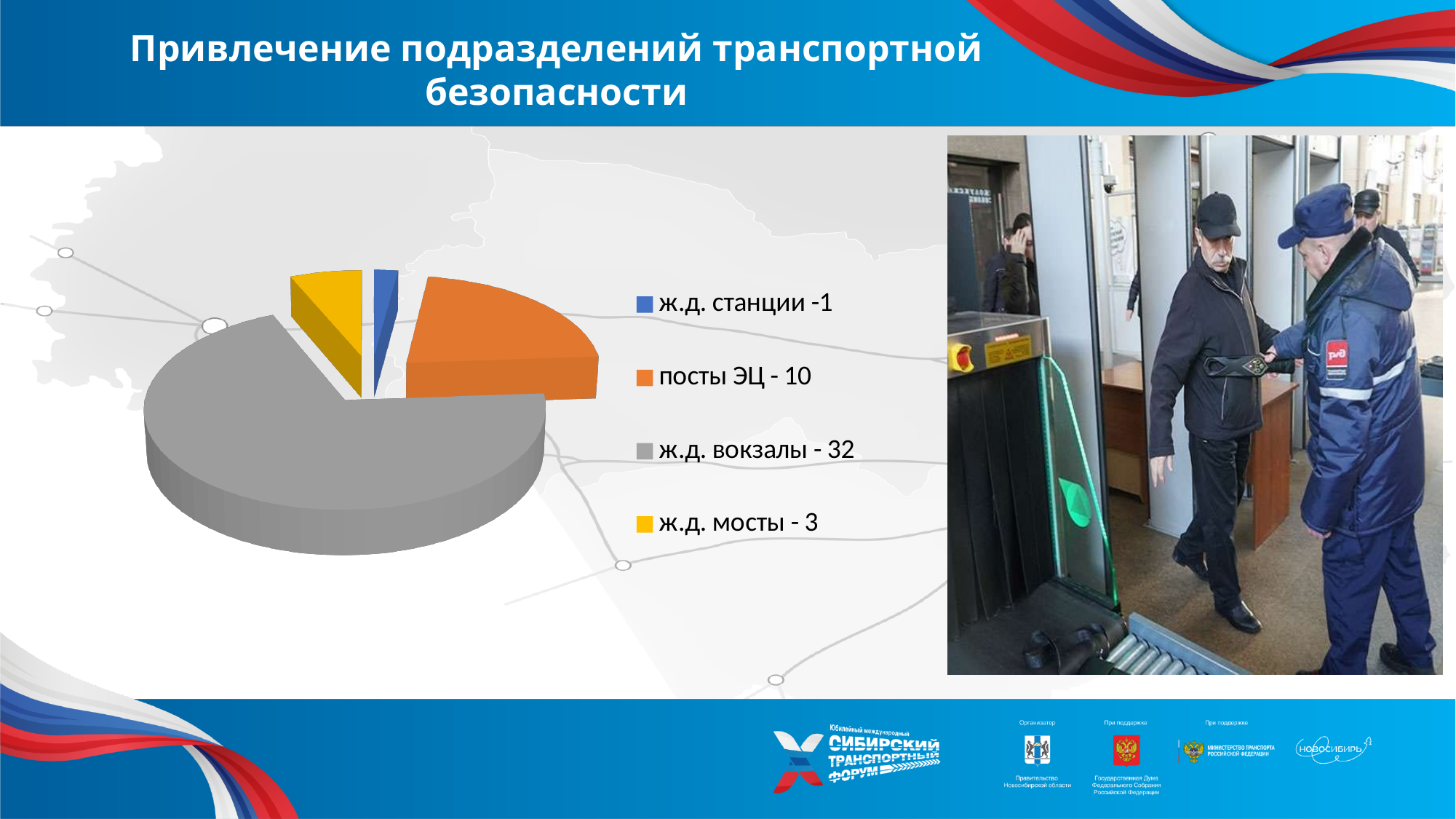
Which is larger, the value for посты ЭЦ or the value for ж.д. мосты? посты ЭЦ How many categories does the pie chart show? 4 What is the difference between the values for ж.д. вокзалы and посты ЭЦ? 22 What kind of chart is shown on the slide? pie chart What is the value for ж.д. мосты? 3 What is the value for ж.д. станции? 1 What colour is the slice for ж.д. мосты? yellow What is the value for посты ЭЦ? 10 Which category has the smallest value in the pie chart? ж.д. станции Which category has the largest value in the pie chart? ж.д. вокзалы What is the value for ж.д. вокзалы? 32 What is the total of all four values in the pie chart? 46